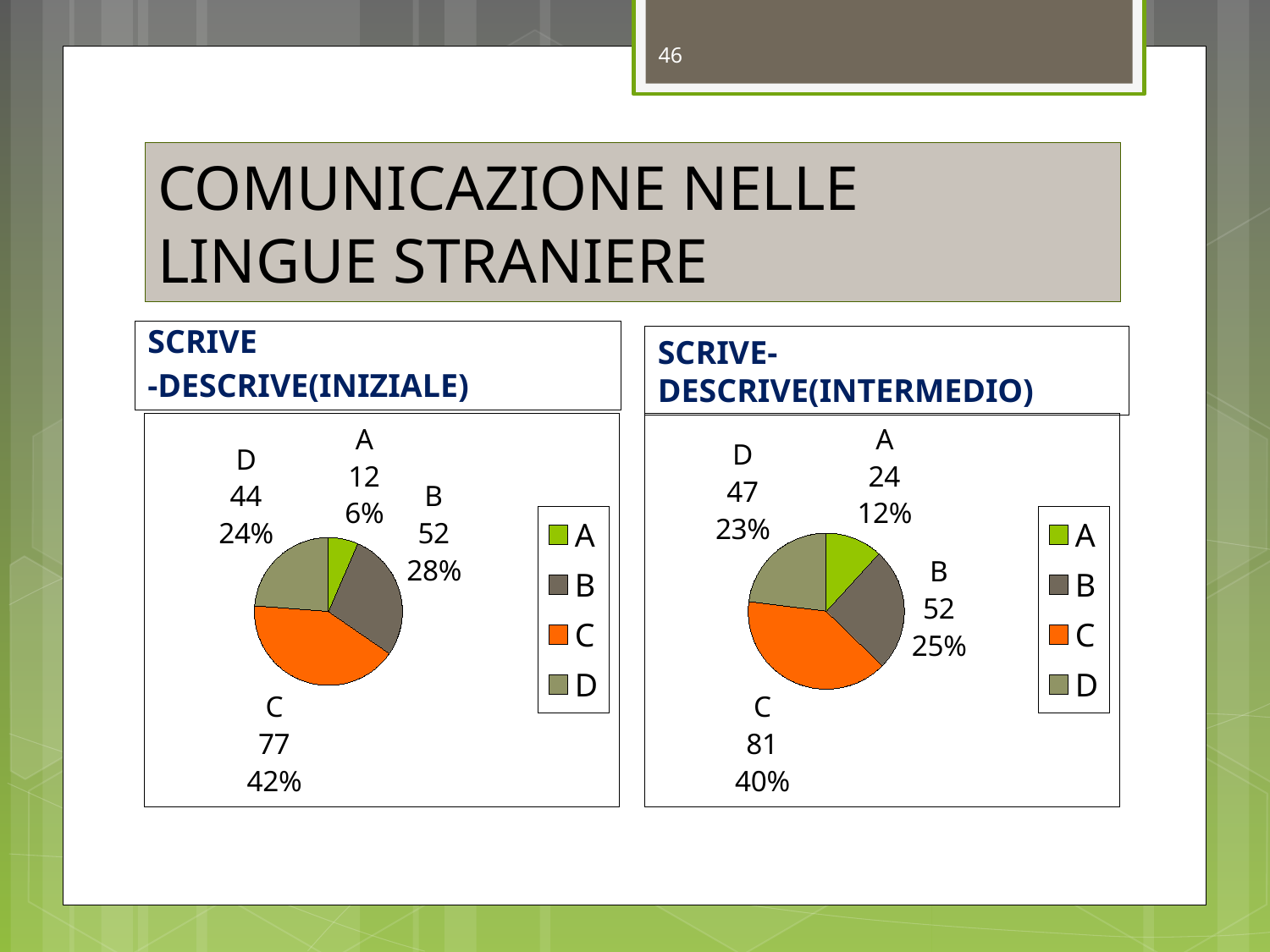
In the SCRIVE-DESCRIVE(INTERMEDIO) chart, what percentage share does C have? 40% How many categories does the SCRIVE-DESCRIVE(INIZIALE) chart show? 4 In the SCRIVE-DESCRIVE(INTERMEDIO) chart, what is the difference between the values for C and D? 34 In the SCRIVE-DESCRIVE(INIZIALE) chart, what percentage share does D have? 24% What kind of chart is the SCRIVE-DESCRIVE(INTERMEDIO) chart? Pie chart In the SCRIVE-DESCRIVE(INTERMEDIO) chart, which category has the largest slice? C In the SCRIVE-DESCRIVE(INIZIALE) chart, what is the difference between the values for B and A? 40 In the SCRIVE-DESCRIVE(INTERMEDIO) chart, which is larger, the value for B or the value for D? B In the SCRIVE-DESCRIVE(INIZIALE) chart, what colour is the slice for C? Orange In the SCRIVE-DESCRIVE(INIZIALE) chart, which category has the smallest slice? A In the SCRIVE-DESCRIVE(INTERMEDIO) chart, what is the value for A? 24 In the SCRIVE-DESCRIVE(INIZIALE) chart, what is the value for C? 77